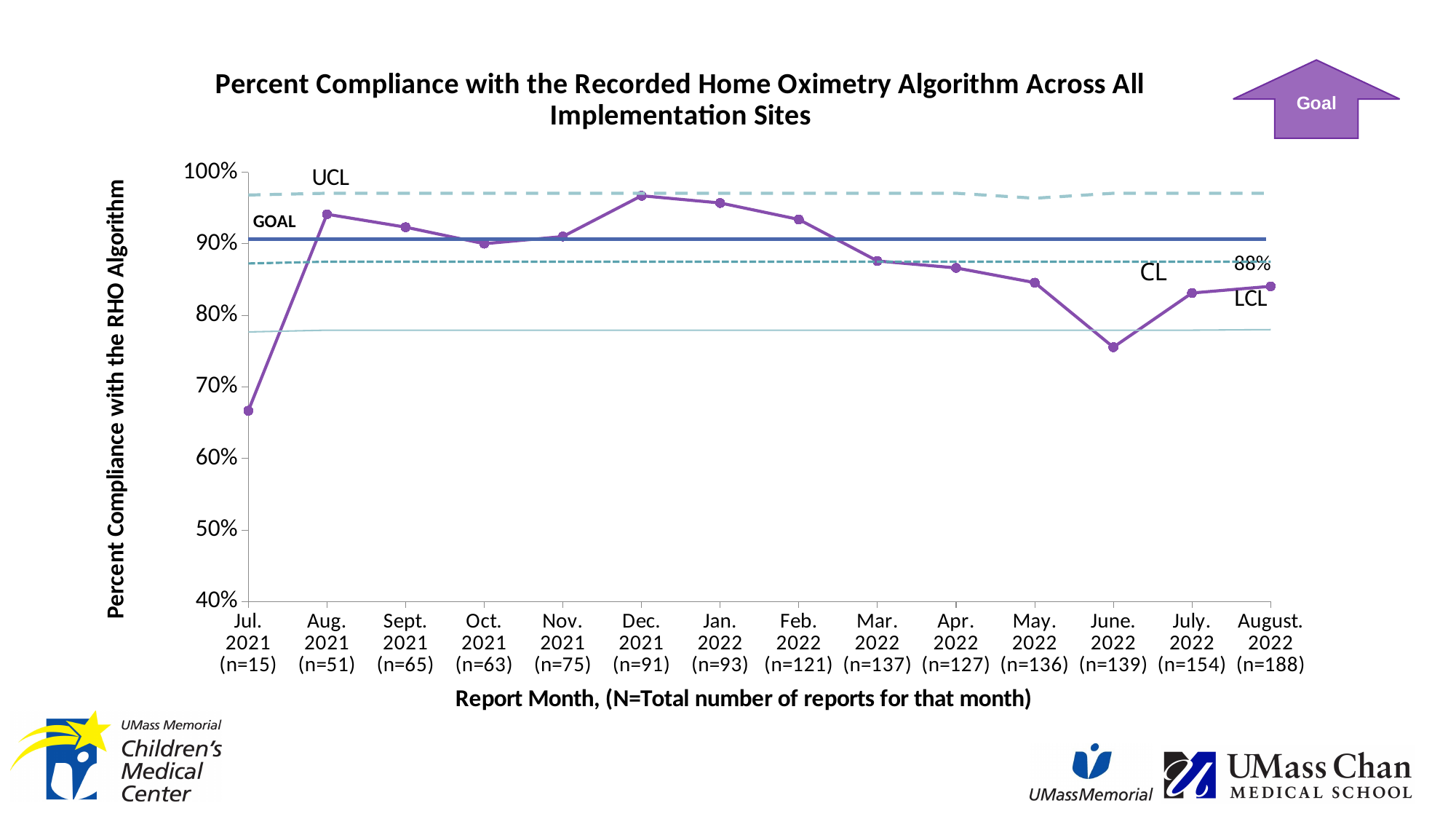
What is the total number of reports (n) for August 2022? 188 Do the percent compliance values rise or fall from Dec. 2021 to June 2022? fall Is the percent compliance for June 2022 greater or less than 80%? less Is the percent compliance for Dec. 2021 greater or less than 90%? greater Which report month has the lowest percent compliance? Jul. 2021 How many monthly data points are plotted on the compliance line? 14 Is the percent compliance for May 2022 greater or less than 90%? less Which has the higher percent compliance, Jul. 2021 or Aug. 2021? Aug. 2021 Which has the higher percent compliance, June 2022 or July 2022? July 2022 What value is printed next to the CL line at the right of the chart? 88% What kind of chart is shown on the slide? line chart